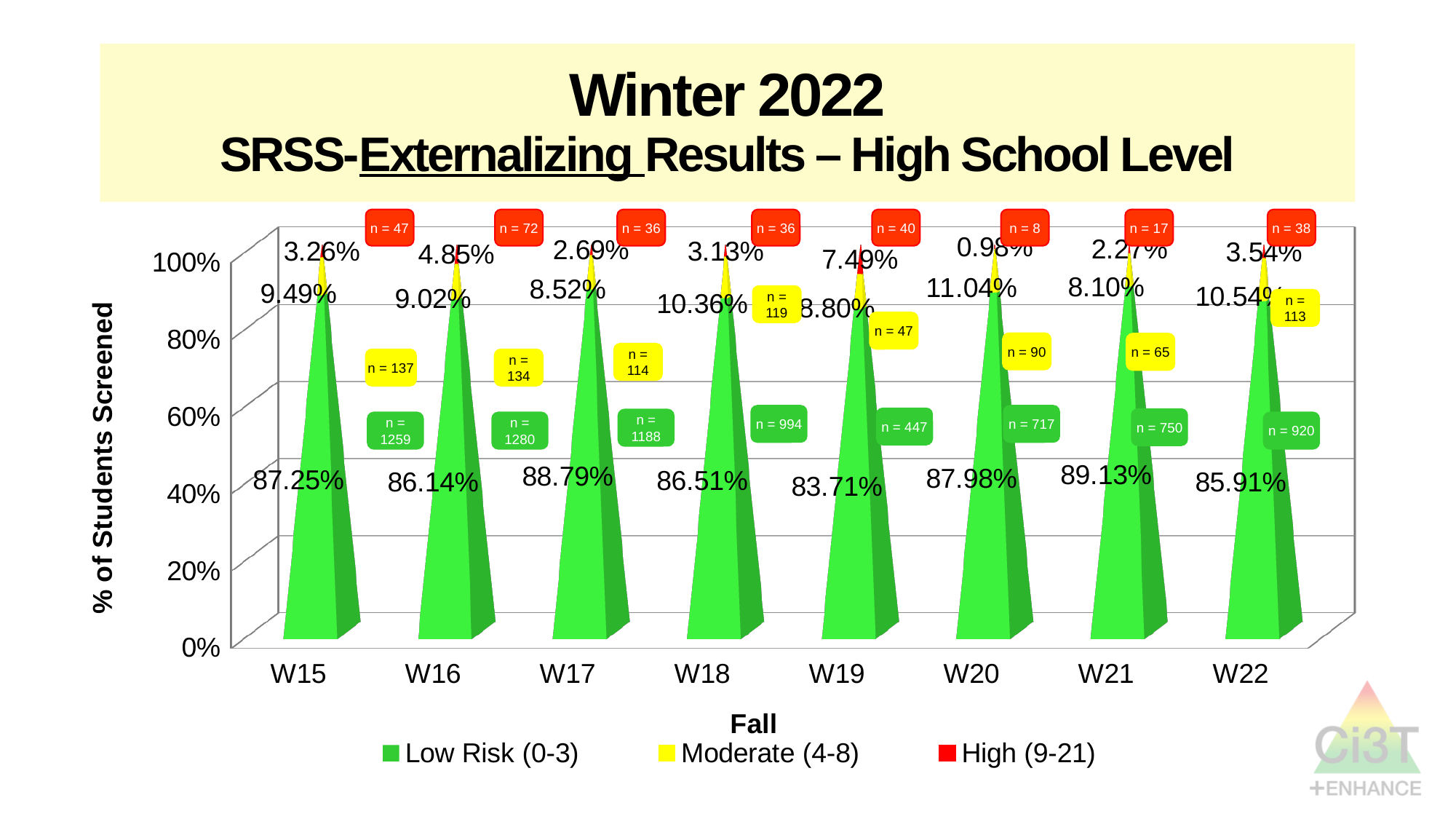
What percentage of students screened were Low Risk (0-3) in W21? 89.13% Is the Moderate (4-8) percentage larger in W18 or in W17? W18 Which screening period has the highest Low Risk (0-3) percentage? W21 What is the label on the y axis? % of Students Screened What is the n value shown for the Low Risk (0-3) group in W16? n = 1280 Which screening period has the highest High (9-21) percentage? W19 What percentage of students screened were High (9-21) in W19? 7.49% Which screening period has the lowest High (9-21) percentage? W20 How many screening periods are shown on the x axis? 8 What is the difference between the Low Risk (0-3) percentages in W21 and W19? 5.42% How many series does the legend list? 3 What percentage of students screened were Moderate (4-8) in W20? 11.04%